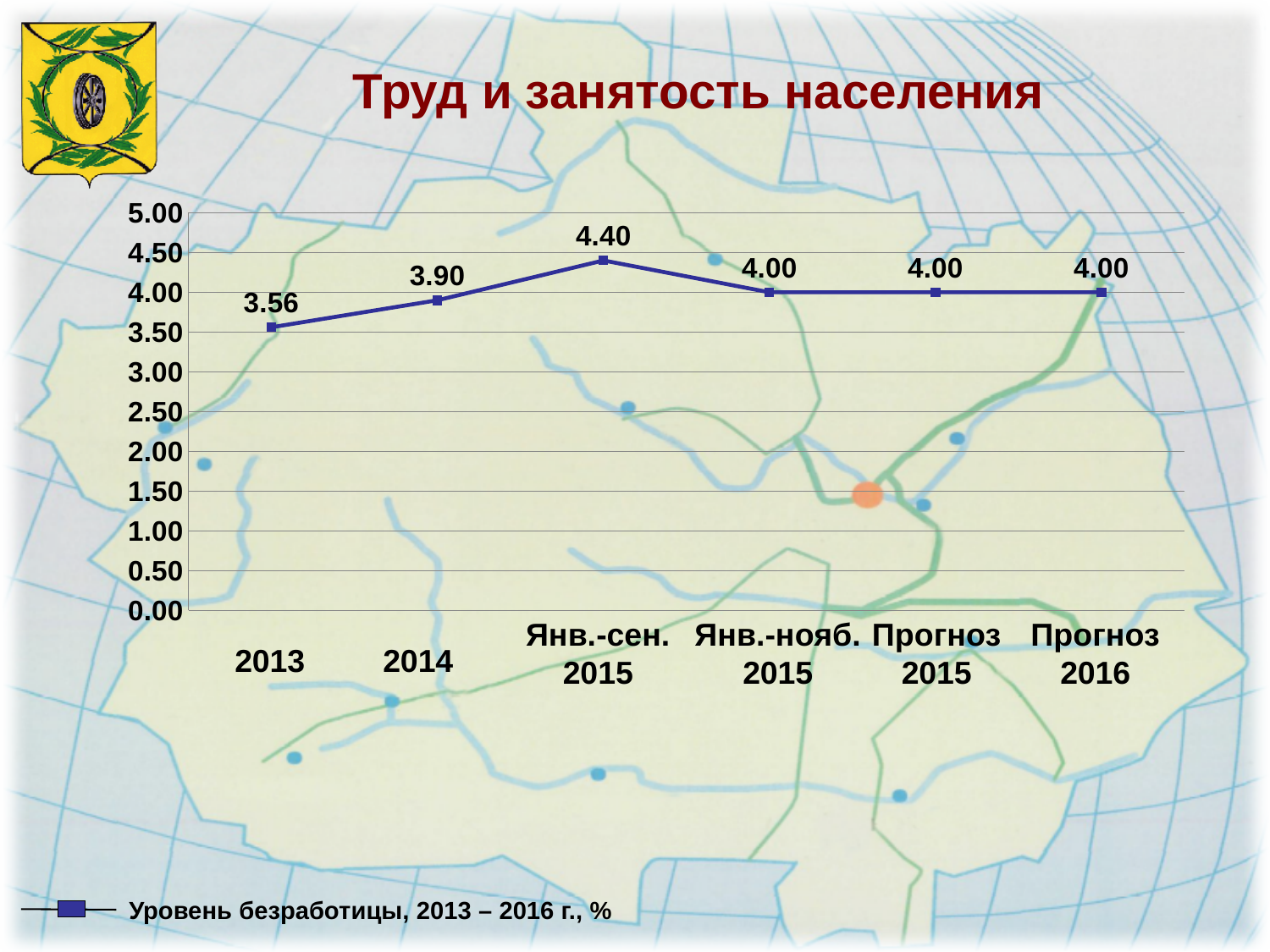
What is the difference between the values for Янв.-сен. 2015 and 2013? 0.84 What is the value for 2014? 3.90 What is the difference between the values for 2014 and 2013? 0.34 How many data points are plotted on the chart? 6 What is the value for Прогноз 2016? 4.00 What is the value for Янв.-сен. 2015? 4.40 What kind of chart is shown on the slide? line chart Which category has the lowest value? 2013 What is the unemployment rate value for 2013? 3.56 Which is larger, the value for 2014 or the value for Янв.-нояб. 2015? Янв.-нояб. 2015 Which category has the highest value? Янв.-сен. 2015 What series name does the legend show? Уровень безработицы, 2013 – 2016 г., %